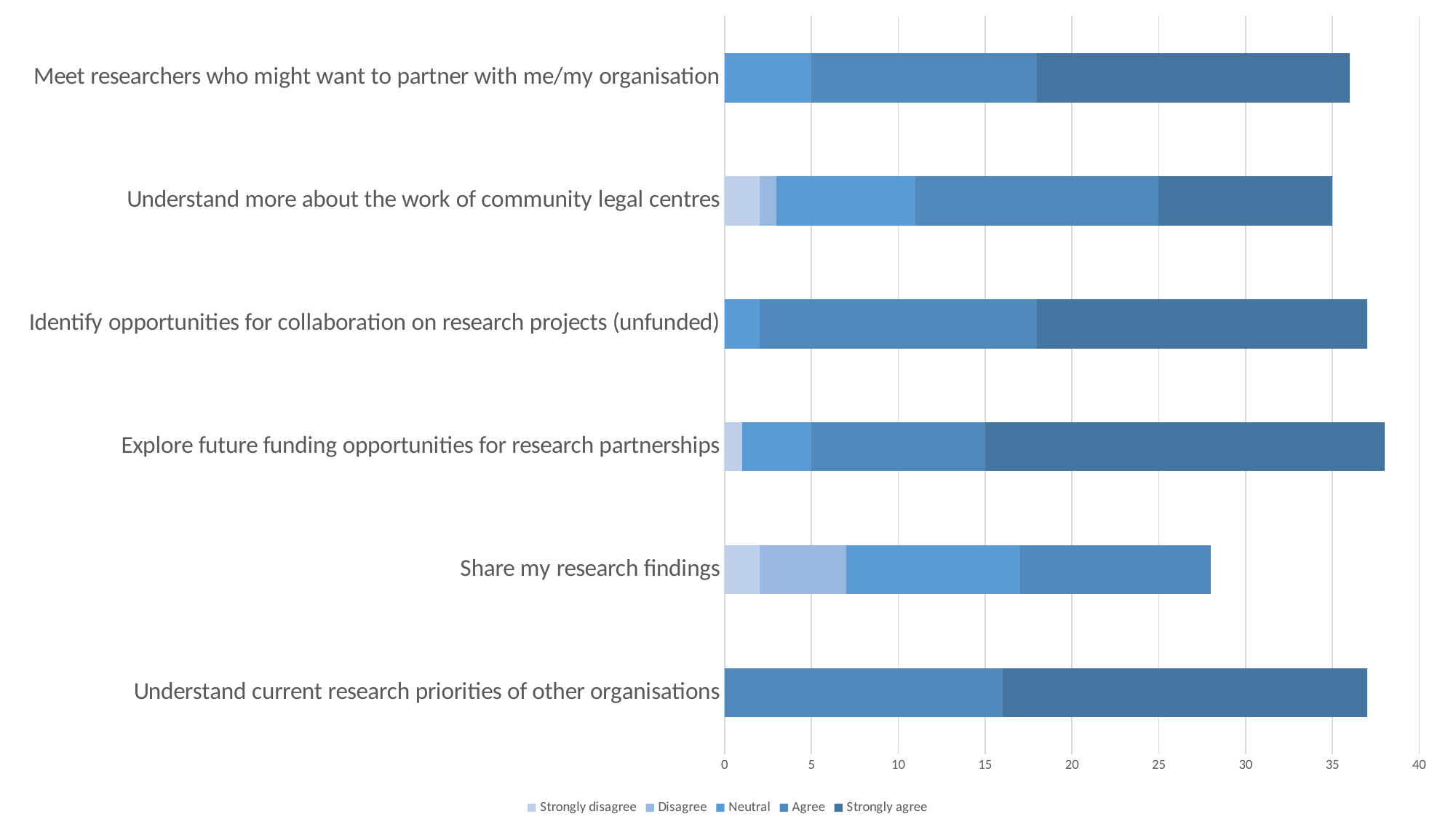
Is the 'Strongly agree' segment for 'Explore future funding opportunities for research partnerships' greater or less than 20? greater Which has the longer total bar: 'Explore future funding opportunities for research partnerships' or 'Share my research findings'? Explore future funding opportunities for research partnerships How many series does the legend list? 5 How many categories are plotted on the chart? 6 Is the total bar for 'Explore future funding opportunities for research partnerships' greater or less than 35? greater Is the total bar for 'Identify opportunities for collaboration on research projects (unfunded)' greater or less than 35? greater What are the five legend entries, from left to right? Strongly disagree, Disagree, Neutral, Agree, Strongly agree What kind of chart is shown on the slide? Stacked bar chart Which category has the lowest total bar length? Share my research findings Which category has no 'Strongly agree' segment? Share my research findings Which has the longer total bar: 'Share my research findings' or 'Understand current research priorities of other organisations'? Understand current research priorities of other organisations